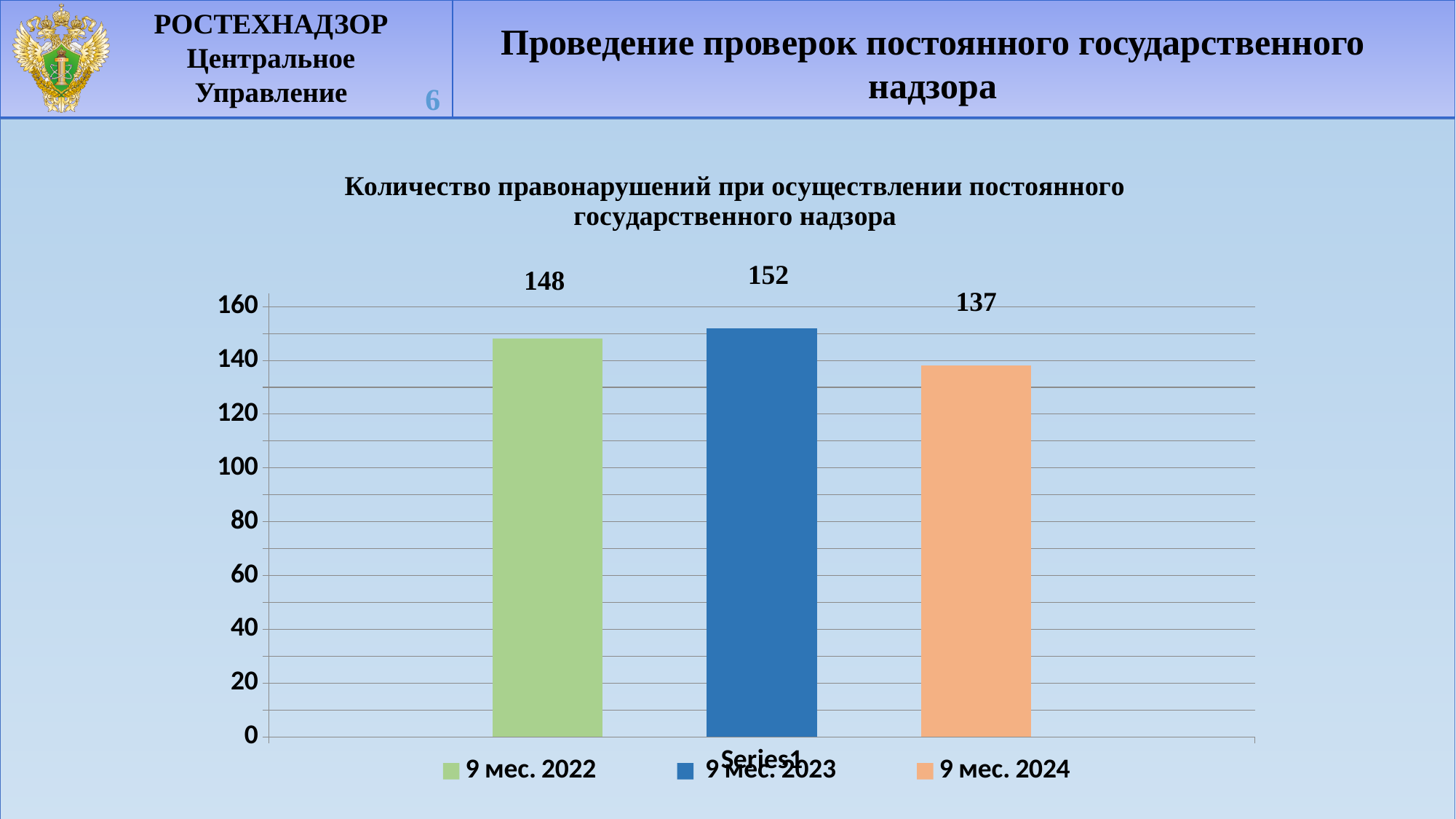
What colour is the bar for 9 мес. 2023? blue What is the value for 9 мес. 2024? 137 How many series does the legend list? 3 What is the difference between the values for 9 мес. 2023 and 9 мес. 2024? 15 What is the difference between the values for 9 мес. 2022 and 9 мес. 2024? 11 Is the value for 9 мес. 2024 greater or less than 140? less What kind of chart is shown on the slide? bar chart What is the value for 9 мес. 2023? 152 Which period has the lowest value? 9 мес. 2024 Which is larger, the value for 9 мес. 2022 or 9 мес. 2024? 9 мес. 2022 What is the value for 9 мес. 2022? 148 Which period has the highest value? 9 мес. 2023